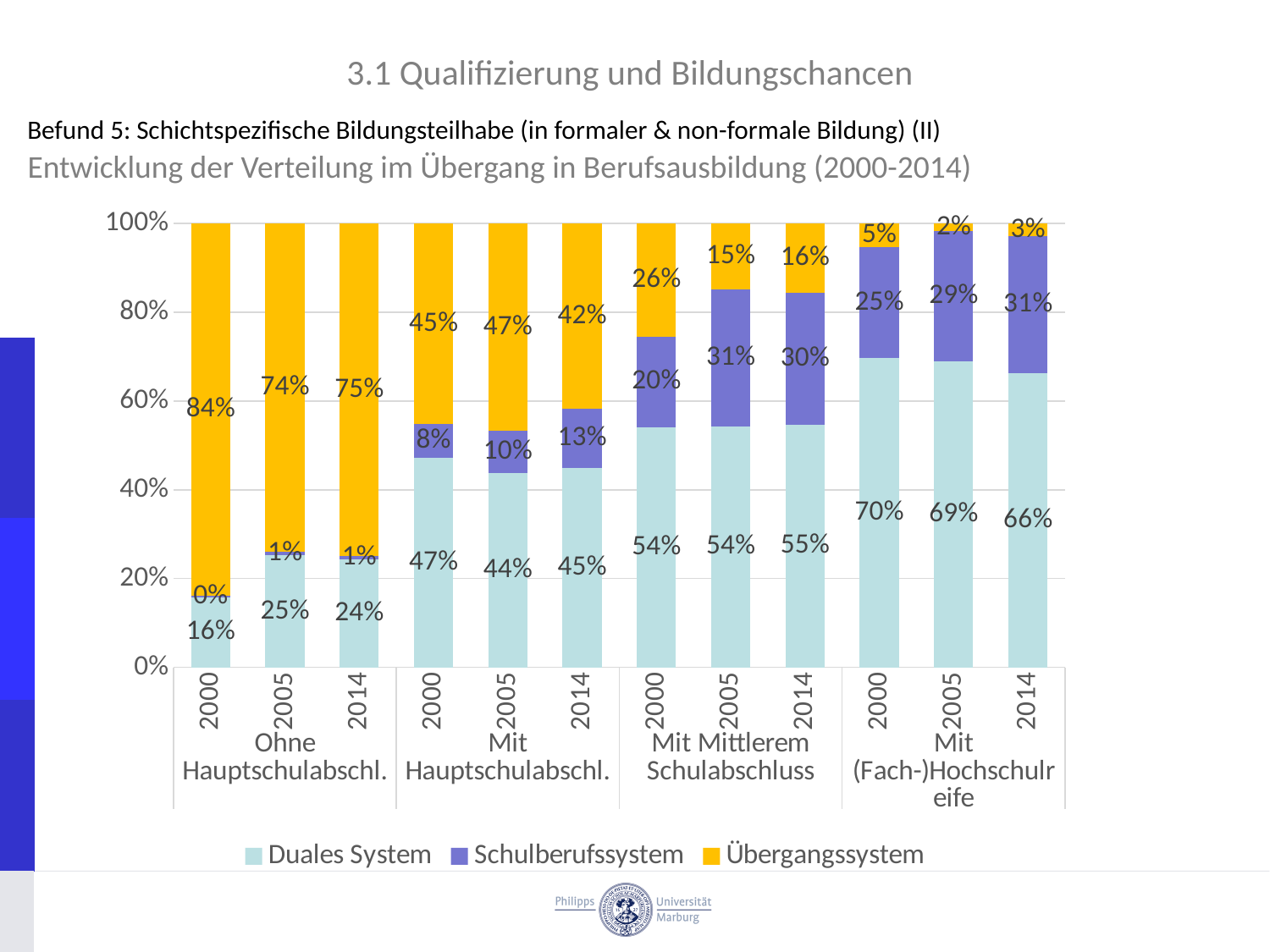
What is the value for Duales System for 2005 in the Mit Hauptschulabschl. group? 44% What is the difference between the Duales System values for 2000 and 2014 in the Mit (Fach-)Hochschulreife group? 4% Which bar has the lowest Duales System share? 2000, Ohne Hauptschulabschl. What kind of chart is shown on the slide? Stacked bar chart Does the Schulberufssystem share in the Mit (Fach-)Hochschulreife group rise or fall from 2000 to 2014? Rise What is the value for Übergangssystem for 2000 in the Ohne Hauptschulabschl. group? 84% What is the value for Schulberufssystem for 2005 in the Mit Mittlerem Schulabschluss group? 31% How many bars are plotted in the chart? 12 What is the value for Duales System for 2014 in the Mit (Fach-)Hochschulreife group? 66% How many series does the legend list? 3 Which bar has the highest Übergangssystem share? 2000, Ohne Hauptschulabschl. Which is larger: the Übergangssystem value for 2005 in the Mit Hauptschulabschl. group or for 2005 in the Ohne Hauptschulabschl. group? 2005 in the Ohne Hauptschulabschl. group